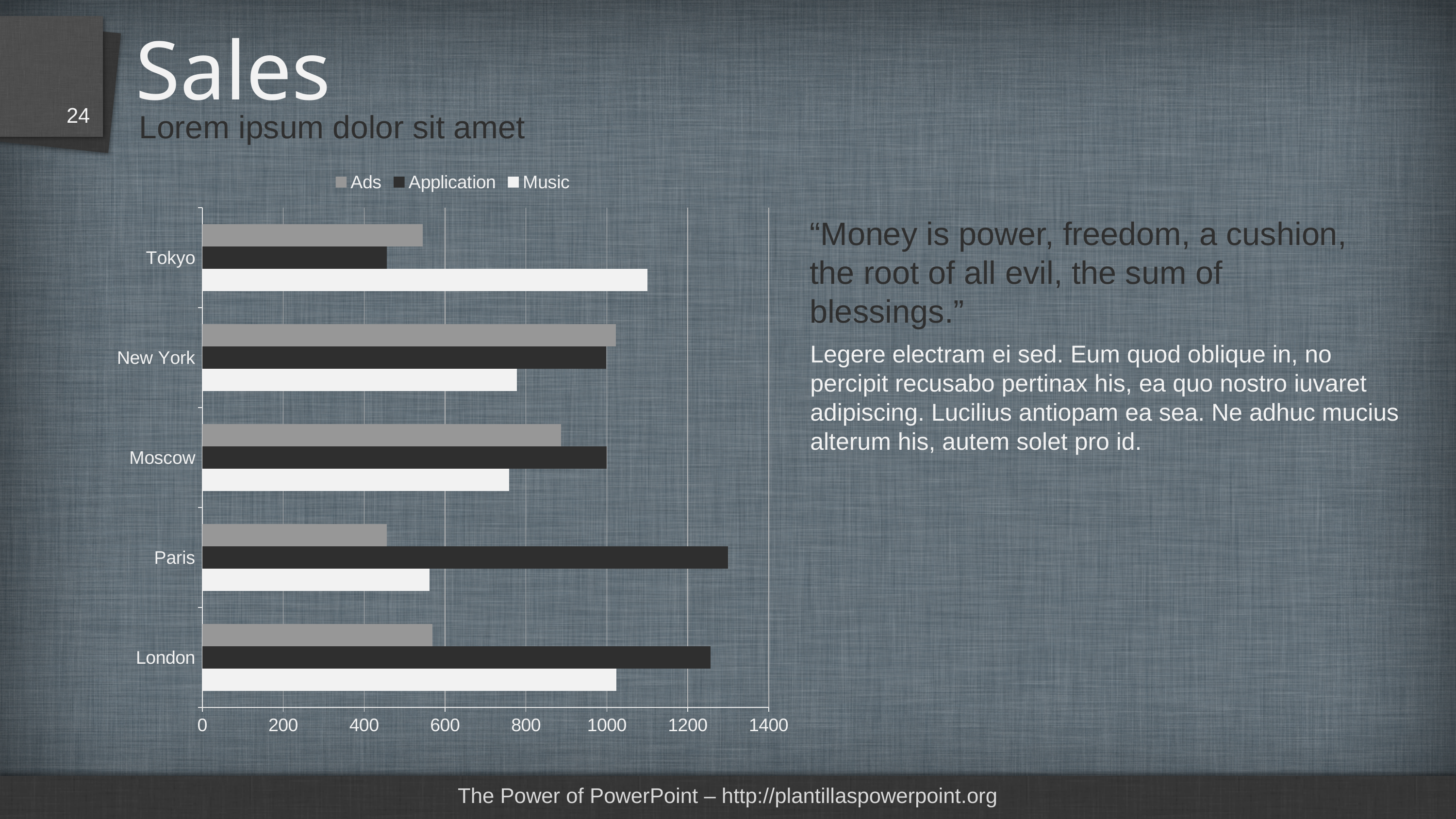
Is the Application value for Tokyo greater or less than 600? less For Tokyo, which is larger: the Music value or the Ads value? Music Which city has the highest Ads value? New York Is the Ads value for Moscow greater or less than 800? greater For Paris, which is larger: the Application value or the Ads value? Application Which series is shown in black in the chart legend? Application How many series does the chart legend list? 3 How many cities are shown on the chart? 5 Is the Music value for Tokyo greater or less than 1000? greater Which city has the lowest Application value? Tokyo What kind of chart is shown on the slide? bar chart